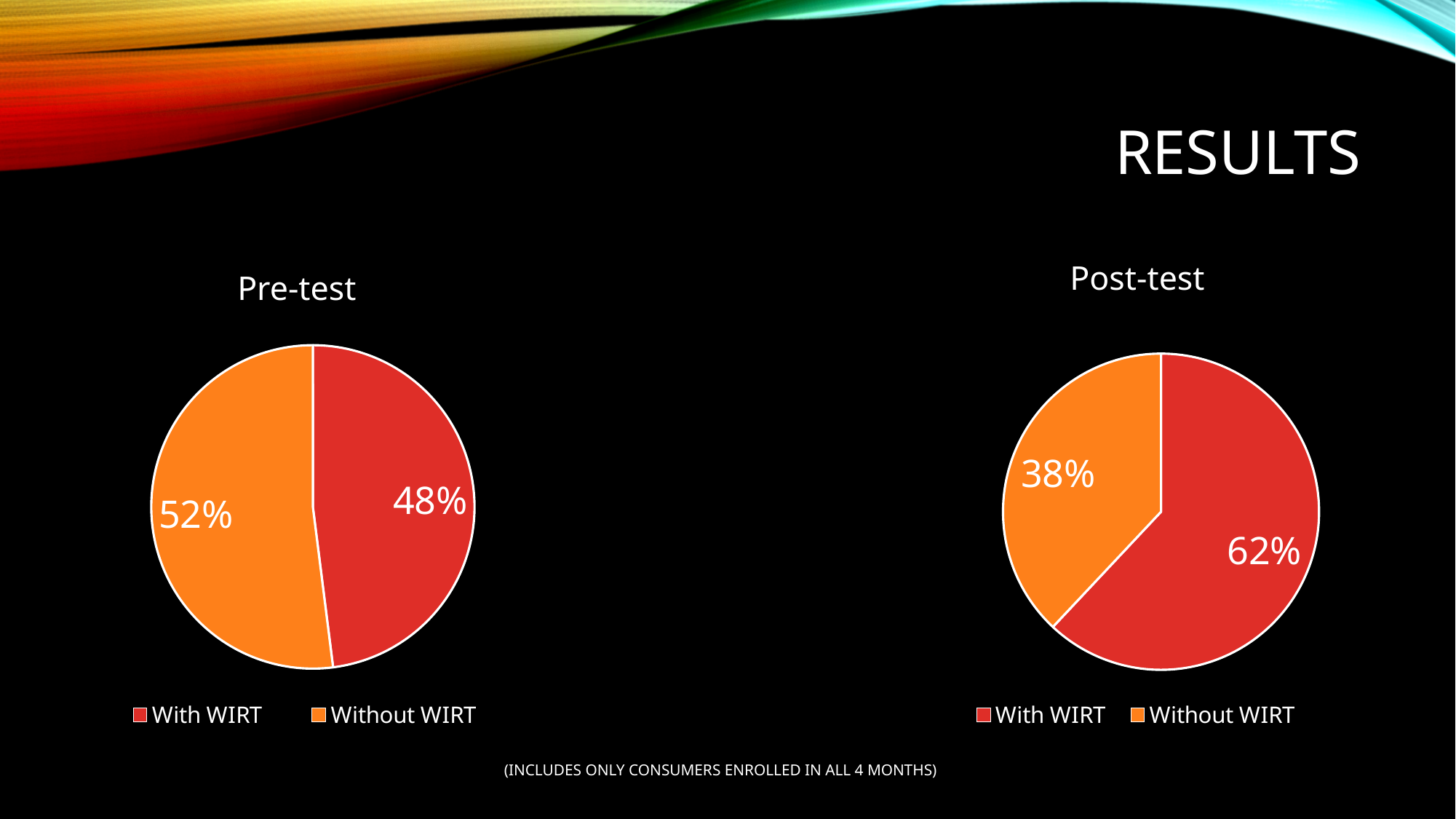
In the Pre-test chart, which is larger: With WIRT or Without WIRT? Without WIRT In the Pre-test chart, what is the value for Without WIRT? 52% In the Pre-test chart, which category has the smallest slice? With WIRT In the Post-test chart, what is the value for With WIRT? 62% In the Post-test chart, what is the difference between the With WIRT and Without WIRT slices? 24% In the Post-test chart, what is the value for Without WIRT? 38% What kind of chart is the Pre-test chart? Pie chart How many entries does the legend of the Pre-test chart list? 2 In the Post-test chart, what colour is the With WIRT slice? Red How many slices does the Post-test chart have? 2 In the Post-test chart, which category has the largest slice? With WIRT In the Pre-test chart, what is the value for With WIRT? 48%